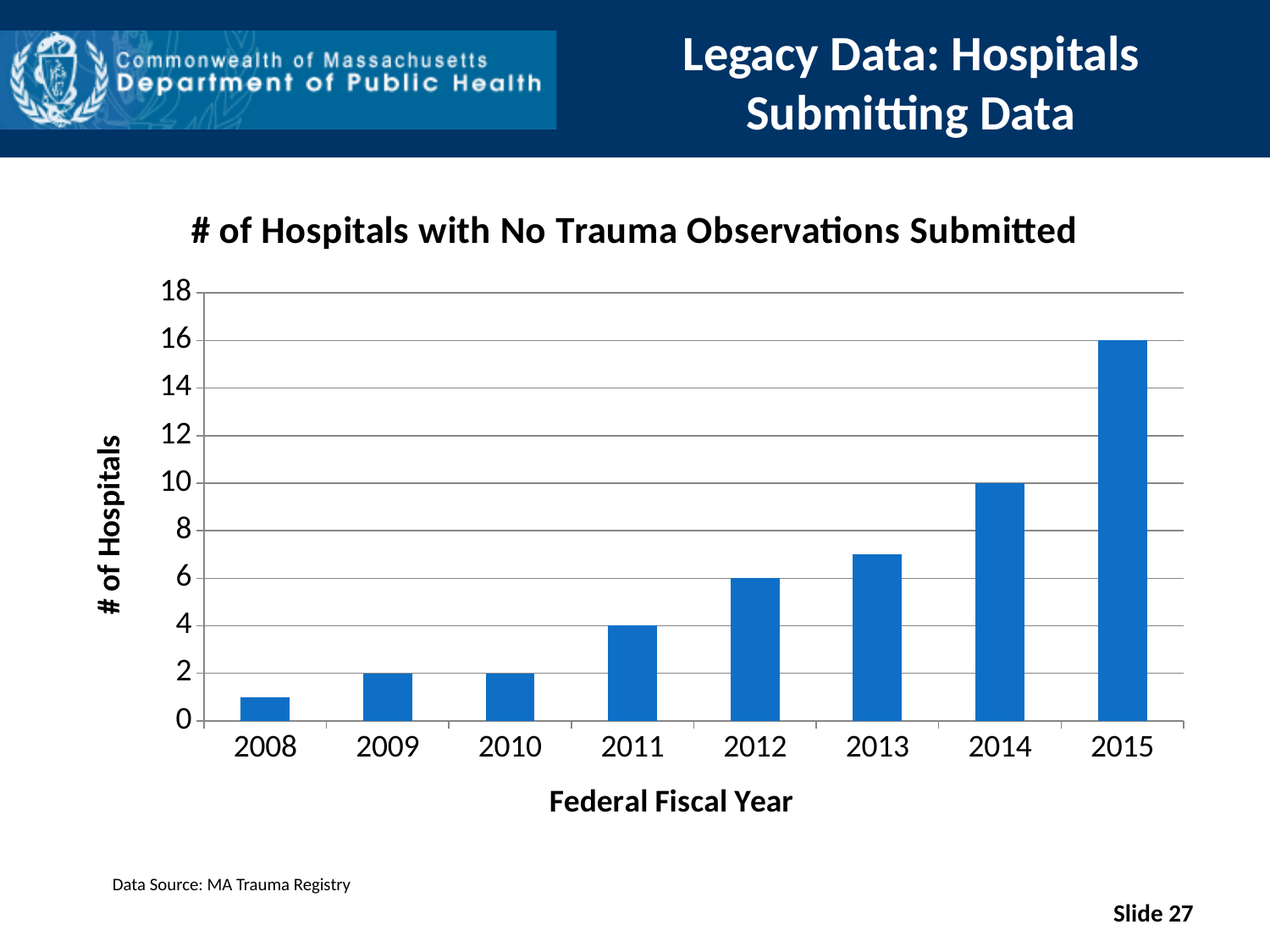
Is the value for 2013 greater or less than 8? less What is the number of hospitals with no trauma observations submitted in 2014? 10 What type of chart is shown on the slide? bar chart Which federal fiscal year has the lowest number of hospitals with no trauma observations submitted? 2008 What is the difference between the number of hospitals in 2015 and in 2014? 6 What is the number of hospitals with no trauma observations submitted in 2015? 16 Do the values generally rise or fall from 2008 to 2015? rise Which federal fiscal year has the highest number of hospitals with no trauma observations submitted? 2015 What is the number of hospitals with no trauma observations submitted in 2012? 6 What is the number of hospitals with no trauma observations submitted in 2011? 4 What is the label of the y axis? # of Hospitals How many federal fiscal years are shown on the x axis? 8